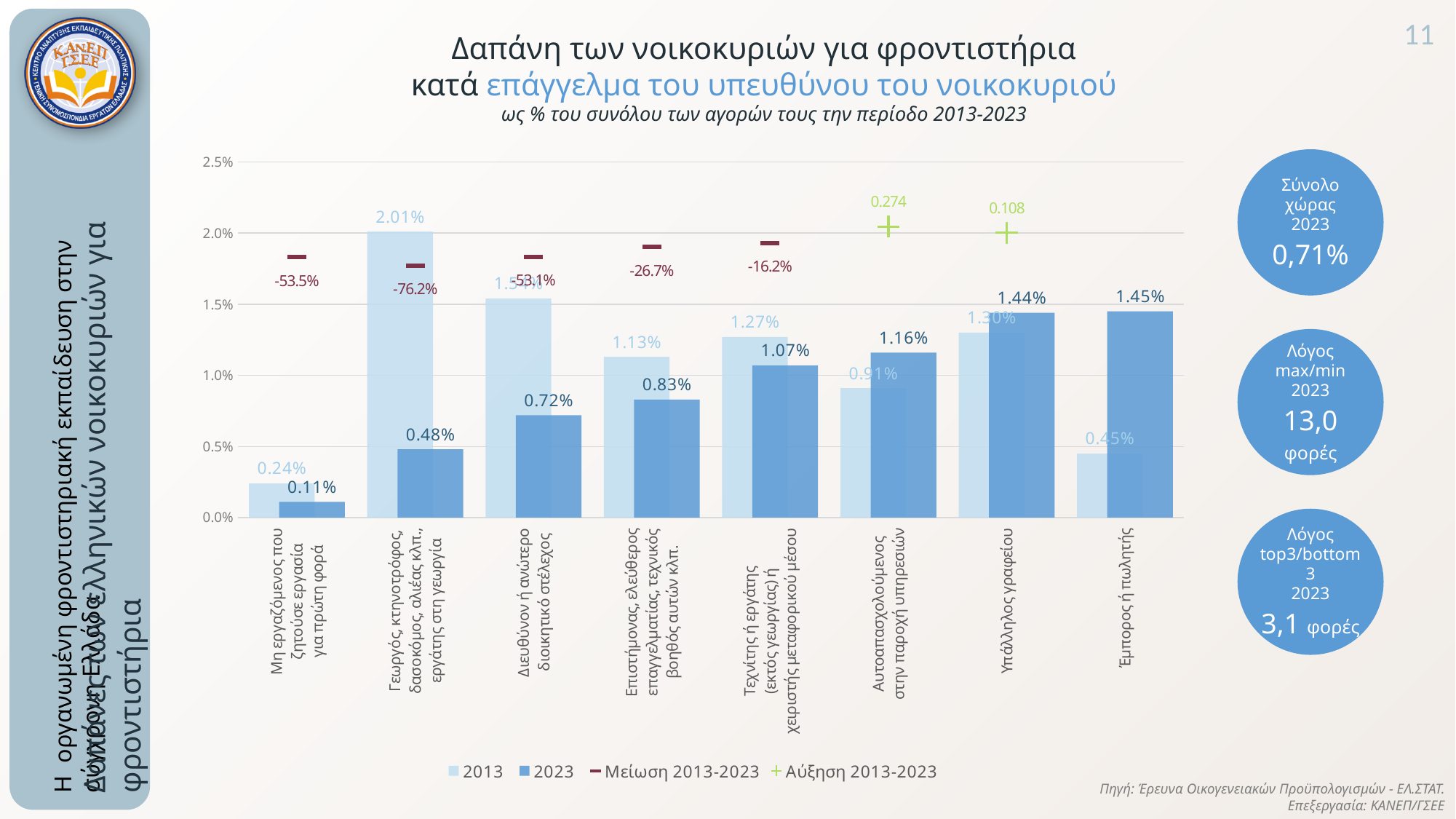
Which category has the lowest 2023 value? Μη εργαζόμενος που ζητούσε εργασία για πρώτη φορά How many occupation categories are shown on the x axis? 8 What percentage change from 2013 to 2023 is shown for Επιστήμονας, ελεύθερος επαγγελματίας, τεχνικός βοηθός αυτών κλπ.? -26.7% What is the difference between the 2013 and 2023 values for Έμπορος ή πωλητής? 1.00 percentage points What is the 2013 value for Γεωργός, κτηνοτρόφος, δασοκόμος, αλιέας κλπ., εργάτης στη γεωργία? 2.01% What is the 2023 value for Έμπορος ή πωλητής? 1.45% How many entries does the legend list? 4 For Υπάλληλος γραφείου, which is larger: the 2013 value or the 2023 value? 2023 Which category has the highest 2013 value? Γεωργός, κτηνοτρόφος, δασοκόμος, αλιέας κλπ., εργάτης στη γεωργία What is the 2023 value for Μη εργαζόμενος που ζητούσε εργασία για πρώτη φορά? 0.11% Is the 2013 value for Αυτοαπασχολούμενος στην παροχή υπηρεσιών greater or less than 1.0%? less What kind of chart is shown on the slide? Bar chart